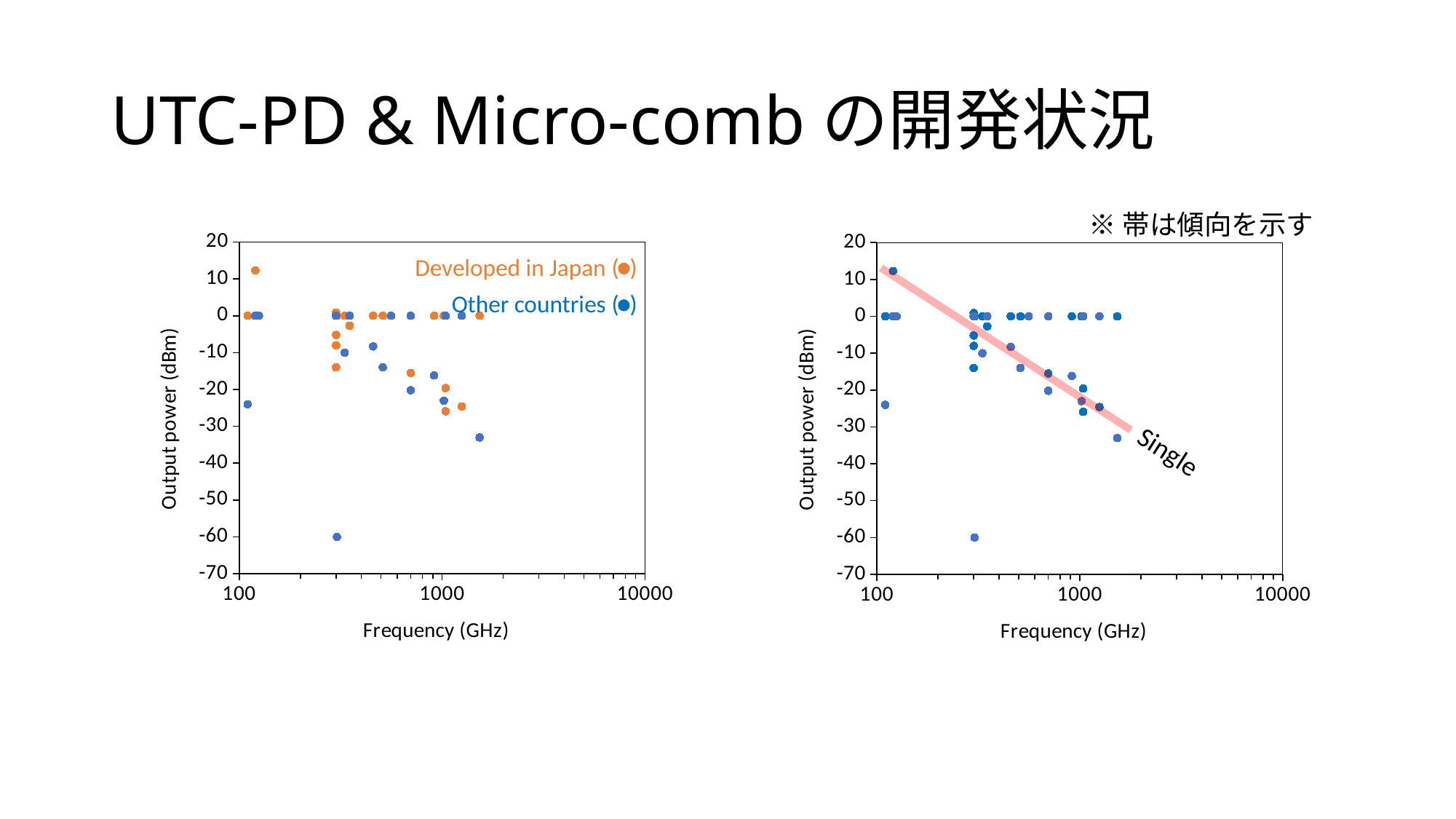
What kind of chart is the left chart on the slide? scatter chart On the left chart, is the highest plotted output power greater or less than 0? greater On the left chart, which series contains the highest plotted point? Developed in Japan What are the two series named in the legend of the left chart? Developed in Japan; Other countries On the left chart, which series contains the lowest plotted point? Other countries On the right chart, is the lowest plotted output power greater or less than -50? less On the right chart, is the highest plotted output power greater or less than 0? greater What label is written next to the trend band on the right chart? Single How many series does the legend of the left chart list? 2 How many charts are shown on the slide? 2 On the right chart, does the trend band show output power rising or falling as frequency increases? falling